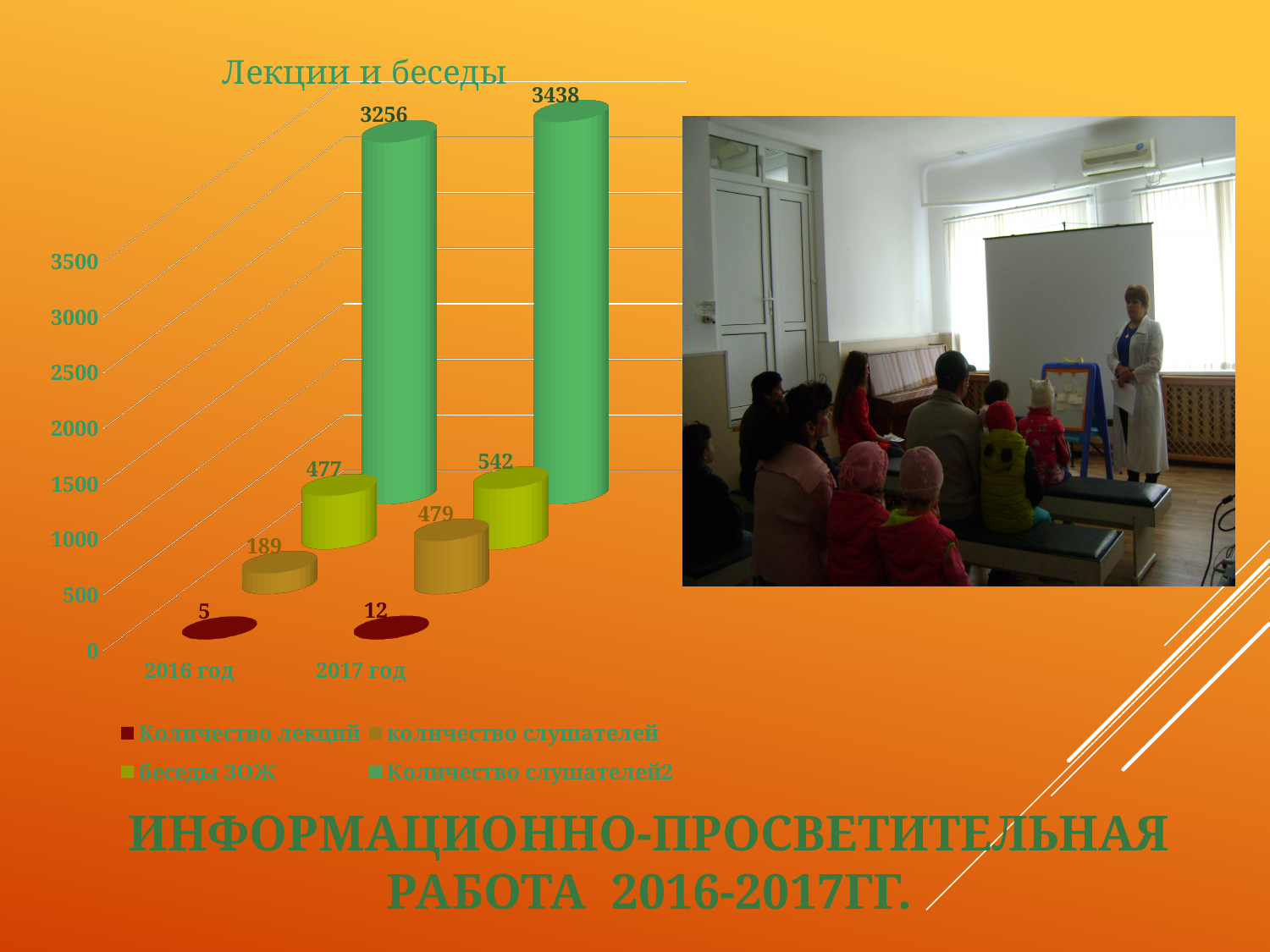
Which series has the highest value for 2017 год? Количество слушателей2 Does the value of 'Количество лекций' rise or fall from 2016 год to 2017 год? rise How many categories are shown on the x axis of the chart? 2 How many series does the chart legend list? 4 What is the difference between the 'Количество слушателей2' values for 2017 год and 2016 год? 182 What type of chart is shown on the slide? bar chart What is the value of 'беседы ЗОЖ' for 2016 год? 477 What is the value of 'количество слушателей' for 2017 год? 479 Which series has the lowest value for 2016 год? Количество лекций What is the value of 'Количество лекций' for 2016 год? 5 What is the title of the chart on the slide? Лекции и беседы What is the value of 'Количество слушателей2' for 2017 год? 3438